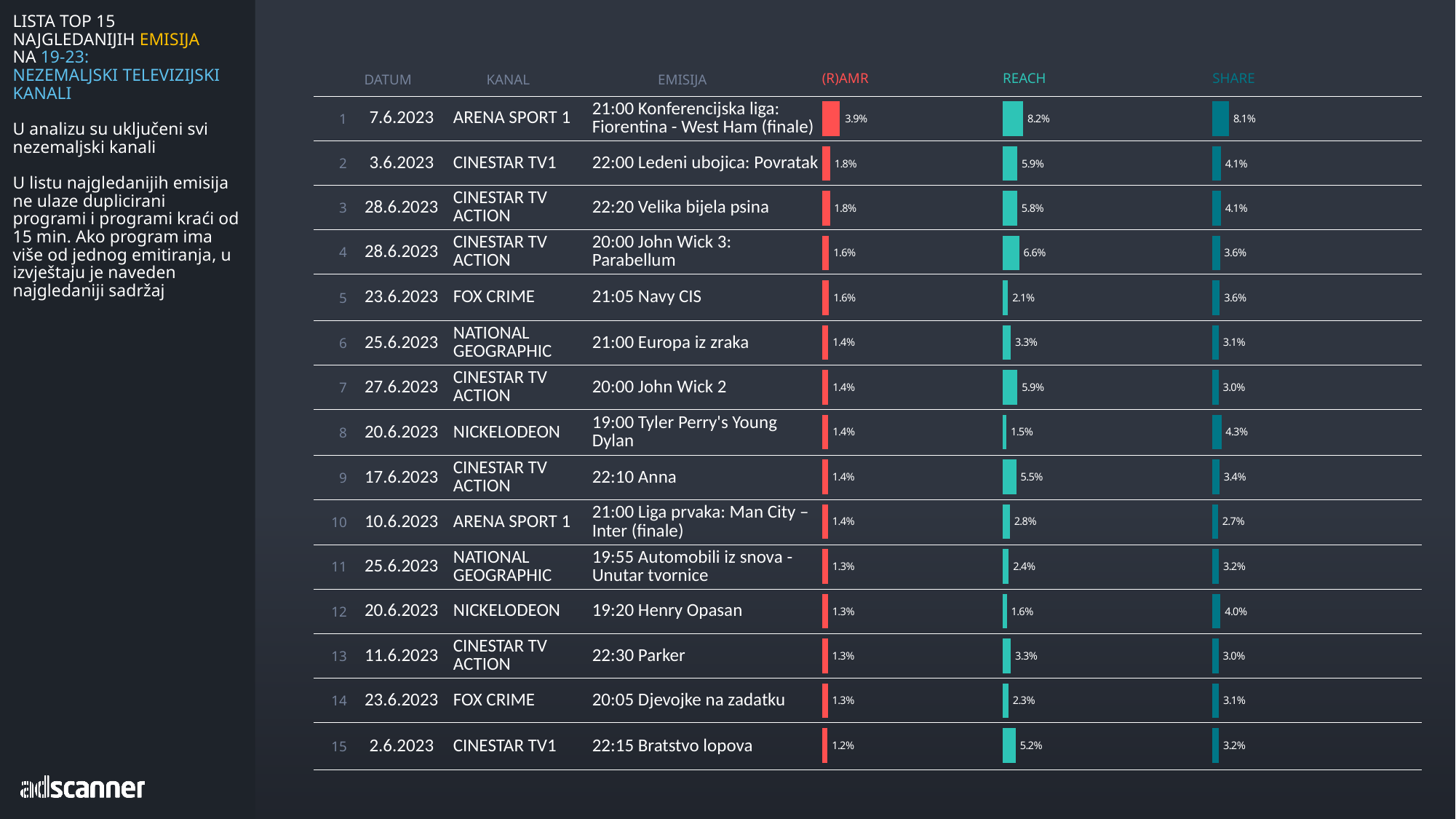
In the SHARE column, what is the value for 19:00 Tyler Perry's Young Dylan? 4.3% In the REACH column, what is the value for 20:00 John Wick 3: Parabellum? 6.6% What colour are the bars in the (R)AMR column? Red In the REACH column, which programme has the lowest value? 19:00 Tyler Perry's Young Dylan How many programmes are listed in the table? 15 In the (R)AMR column, what is the value for the programme ranked 1, 21:00 Konferencijska liga: Fiorentina - West Ham (finale)? 3.9% In the SHARE column, what is the difference between the value for 21:00 Konferencijska liga: Fiorentina - West Ham (finale) and the value for 22:00 Ledeni ubojica: Povratak? 4.0% In the REACH column, which programme has the highest value? 21:00 Konferencijska liga: Fiorentina - West Ham (finale) In the REACH column, which is larger: the value for 21:05 Navy CIS or the value for 22:10 Anna? 22:10 Anna In the (R)AMR column, what is the difference between the value for 21:00 Konferencijska liga: Fiorentina - West Ham (finale) and the value for 22:15 Bratstvo lopova? 2.7% What kind of chart is used in the (R)AMR, REACH and SHARE columns? Bar chart In the (R)AMR column, which programme has the lowest value? 22:15 Bratstvo lopova